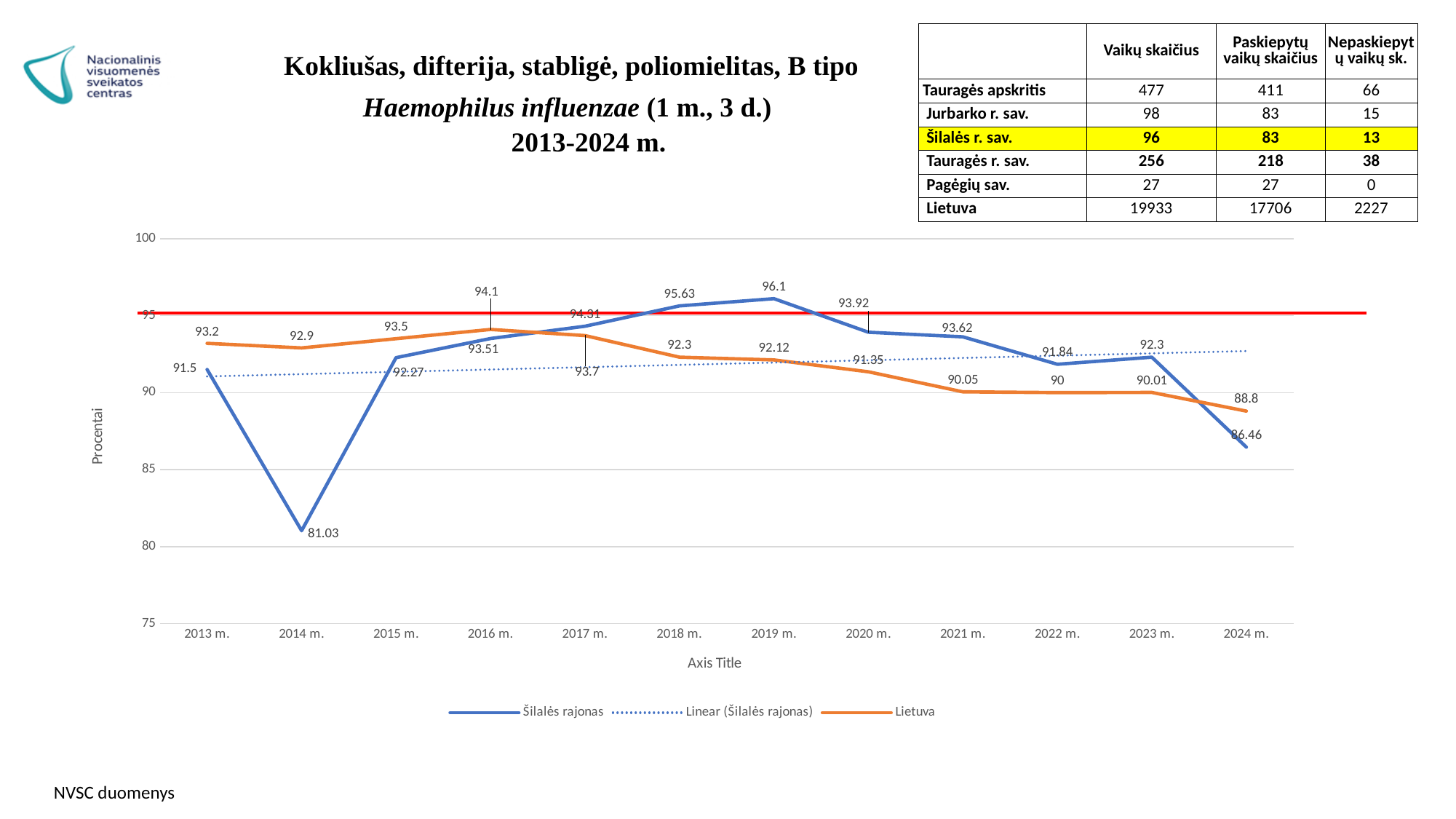
How many entries does the legend list? 3 How many years are shown on the x axis? 12 Is the value for Šilalės rajonas in 2018 m. greater or less than 95? greater In which year is the Šilalės rajonas value lowest? 2014 m. What is the value for Lietuva in 2016 m.? 94.1 What kind of chart is shown? line chart What is the value for Lietuva in 2024 m.? 88.8 In 2013 m., which series has the larger value, Šilalės rajonas or Lietuva? Lietuva What is the difference between Šilalės rajonas and Lietuva in 2019 m.? 3.98 In which year is the Lietuva value highest? 2016 m. In which year is the Šilalės rajonas value highest? 2019 m. What is the value for Šilalės rajonas in 2014 m.? 81.03